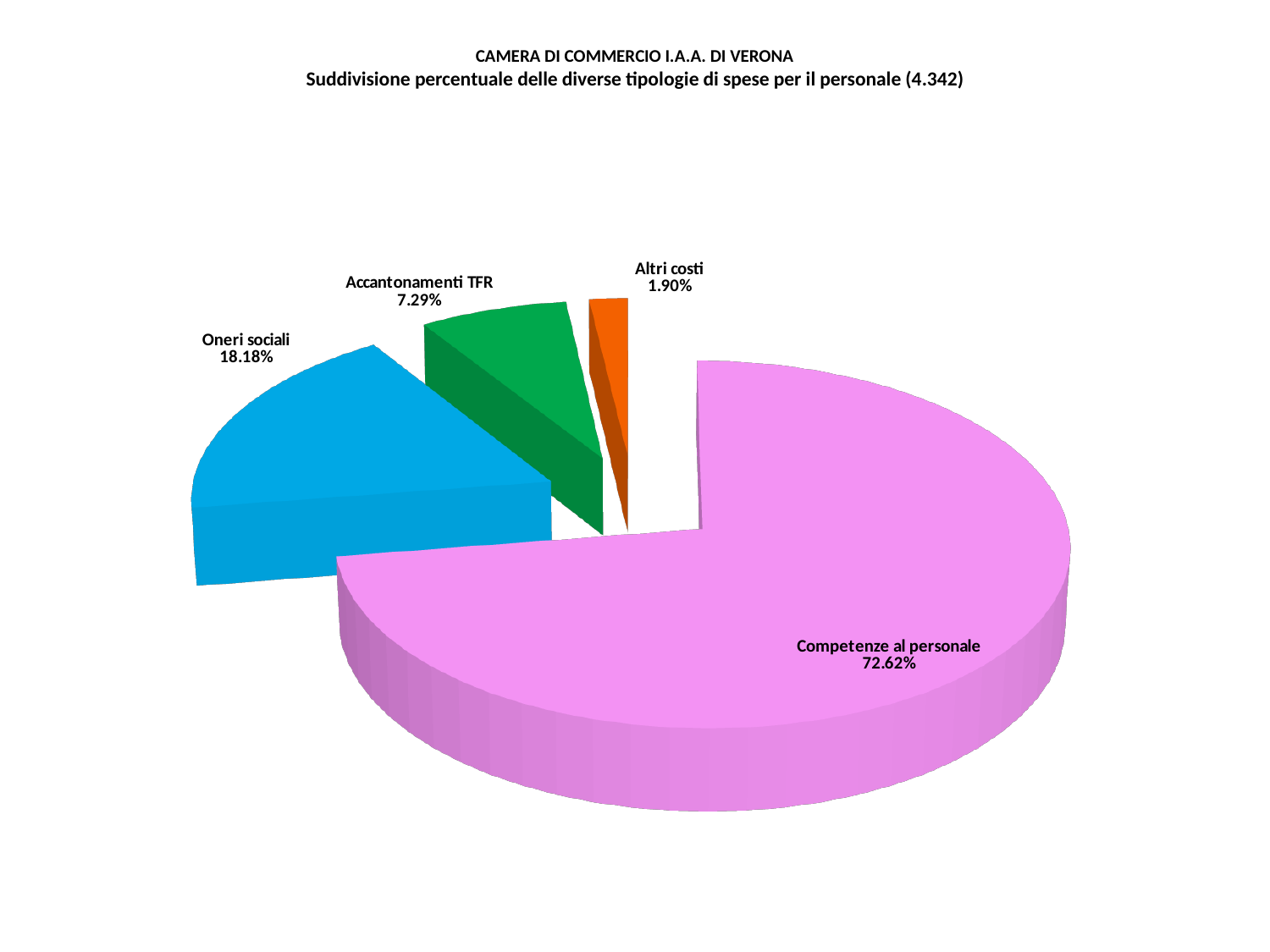
Which category has the smallest slice of the pie chart? Altri costi What percentage share does Competenze al personale have in the pie chart? 72.62% Which category has the largest slice of the pie chart? Competenze al personale Which is larger, the share for Accantonamenti TFR or the share for Altri costi? Accantonamenti TFR What colour is the slice for Oneri sociali? Blue What kind of chart is shown on the slide? Pie chart What percentage share does Oneri sociali have in the pie chart? 18.18% What percentage share does Altri costi have in the pie chart? 1.90% How many categories are shown in the pie chart? 4 What is the difference in percentage points between Oneri sociali and Accantonamenti TFR? 10.89 What percentage share does Accantonamenti TFR have in the pie chart? 7.29% What is the combined share of Oneri sociali and Accantonamenti TFR? 25.47%